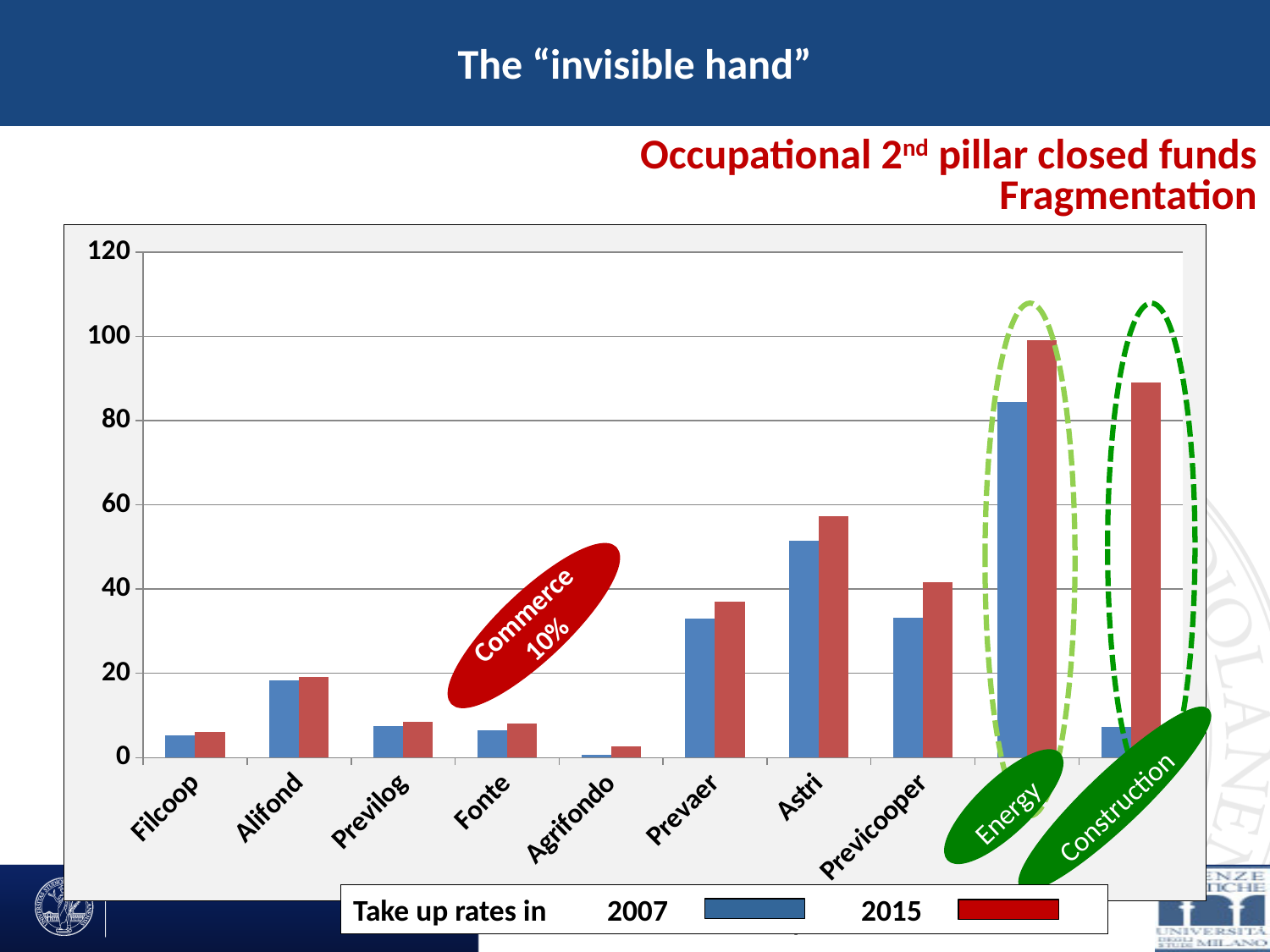
Is the 2015 value for Agrifondo greater or less than 20? less Is the 2007 value for Previcooper greater or less than 40? less Is the 2015 value for Construction greater or less than 80? greater Which fund has the lowest 2015 take-up rate? Agrifondo Which fund has the highest 2015 take-up rate? Energy Which is larger, the 2015 value for Astri or the 2015 value for Prevaer? Astri How many series does the legend list? 2 Which two years are compared in the chart's legend? 2007 and 2015 Which colour represents the 2015 series? red What kind of chart is shown on the slide? bar chart